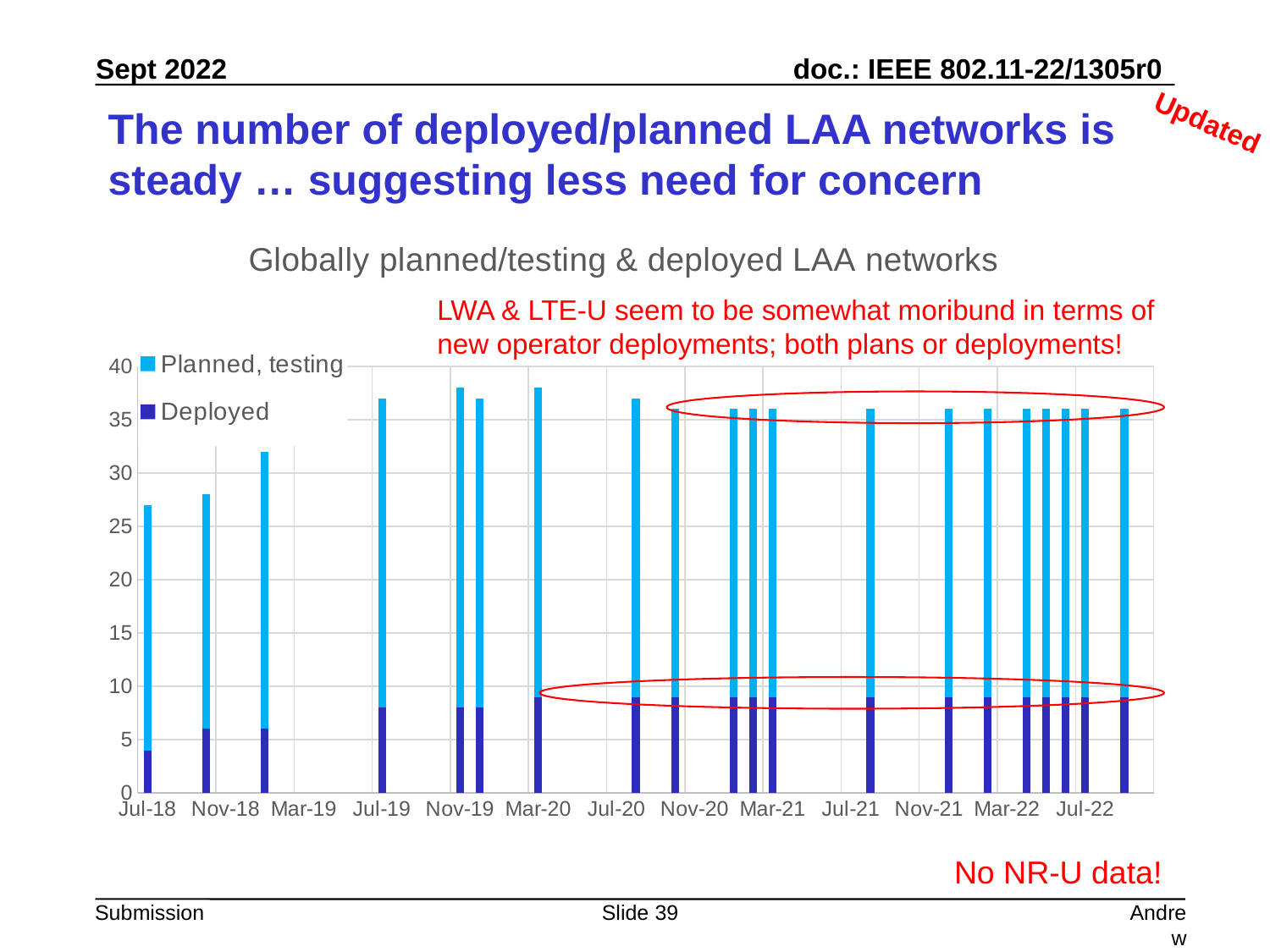
Which bar has the larger total, Jul-18 or Jul-19? Jul-19 Is the total height of the Jul-19 bar greater or less than 35? greater Is the total height of the Jul-18 bar greater or less than 25? greater How many series does the chart legend list? 2 What kind of chart is shown on the slide? Stacked bar chart What is the title of the chart? Globally planned/testing & deployed LAA networks Is the Deployed value for Jul-22 greater or less than 5? greater Which bar has the larger total, Jul-18 or Jul-22? Jul-22 Does the total number of networks rise or fall from Jul-18 to Jul-22? rise What are the two series named in the chart legend? Planned, testing; Deployed